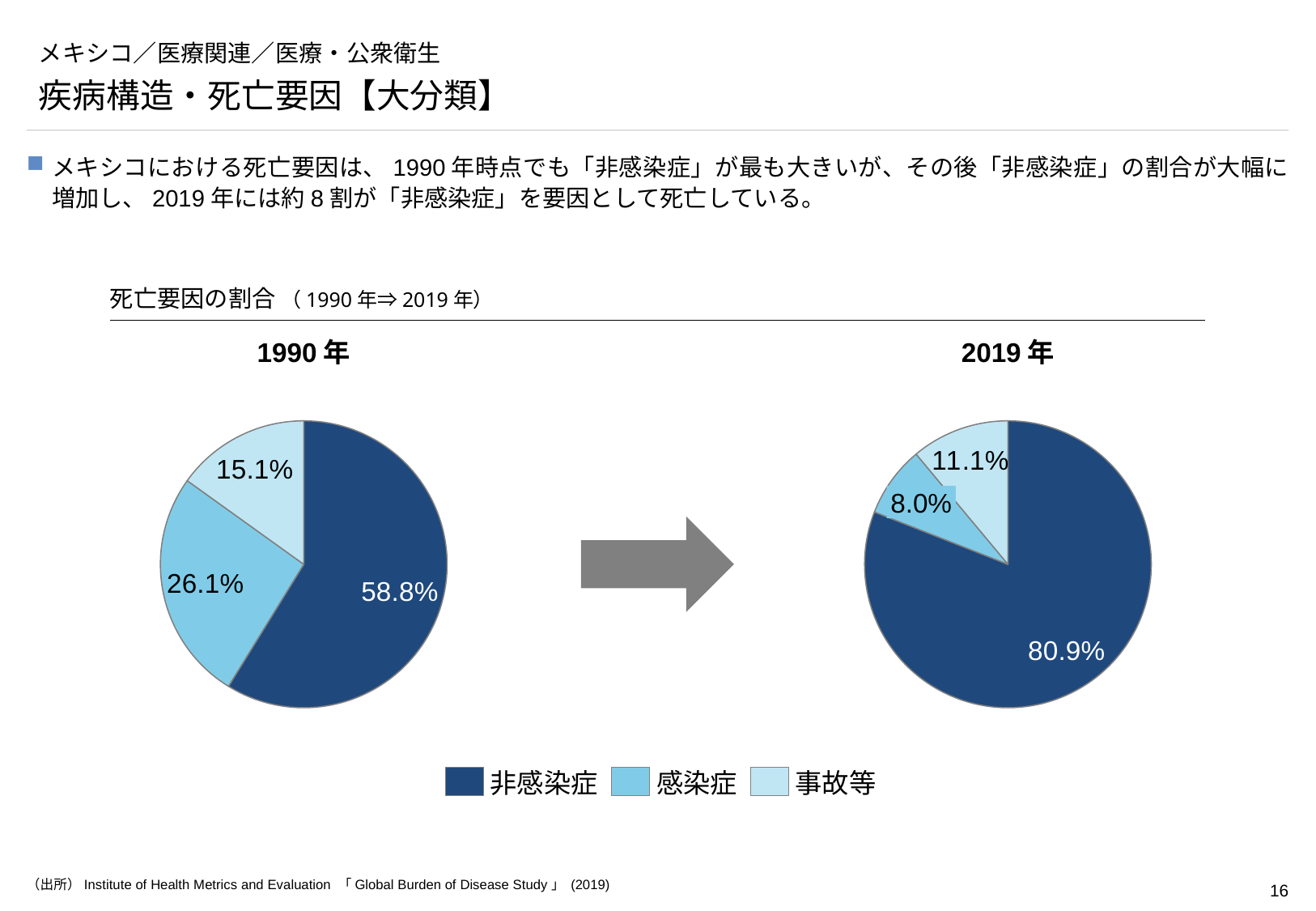
What is the difference between the 非感染症 share in the 2019年 pie chart and the 非感染症 share in the 1990年 pie chart? 22.1% In the 2019年 pie chart, what share is labelled for 感染症? 8.0% In the 2019年 pie chart, what share is labelled for 事故等? 11.1% Which legend category is shown in the darkest blue colour? 非感染症 How many categories does the legend list for the pie charts? 3 In the 2019年 pie chart, which category has the smallest slice? 感染症 Which is larger: the 感染症 share in the 1990年 pie chart or the 事故等 share in the 1990年 pie chart? 感染症 What type of chart is used to show the 死亡要因の割合 for 1990年 and 2019年? Pie chart In the 1990年 pie chart, what share is labelled for 感染症? 26.1% In the 1990年 pie chart, which category has the smallest slice? 事故等 In the 2019年 pie chart, which category has the largest slice? 非感染症 In the 1990年 pie chart, what share is labelled for 非感染症? 58.8%